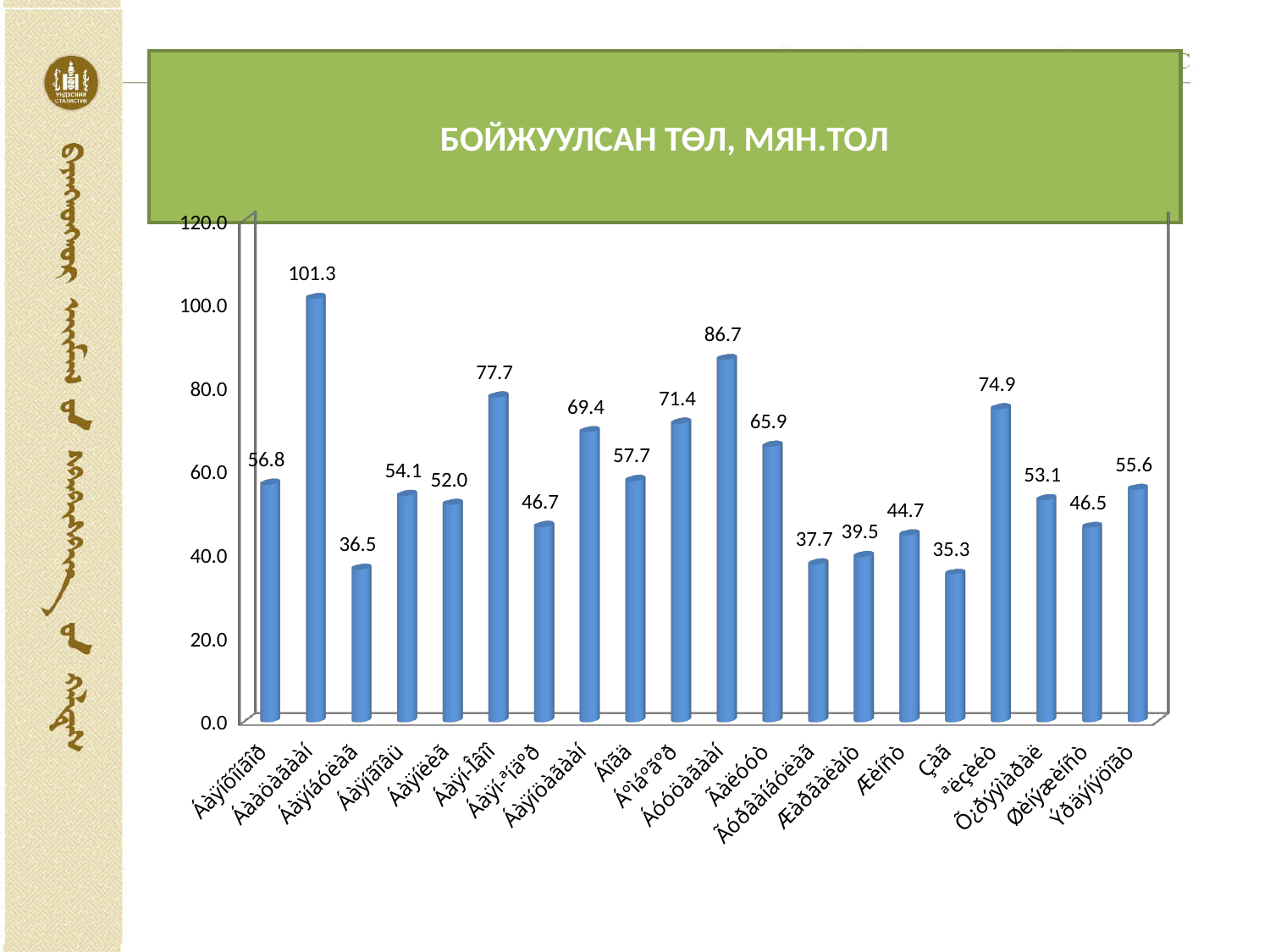
How many bars are plotted in the chart? 20 What kind of chart is shown on the slide? bar chart Is the value of the third bar from the left greater or less than 40.0? less What is the value of the second bar from the left? 101.3 What is the lowest value shown in the chart? 35.3 What is the title of the chart? БОЙЖУУЛСАН ТӨЛ, МЯН.ТОЛ What is the value of the first bar on the left? 56.8 What is the value of the last bar on the right? 55.6 What is the highest value shown in the chart? 101.3 What is the difference between the highest value (101.3) and the lowest value (35.3) in the chart? 66.0 What is the maximum value shown on the vertical axis? 120.0 Which is larger: the value of the sixth bar from the left (77.7) or the eleventh bar from the left (86.7)? 86.7